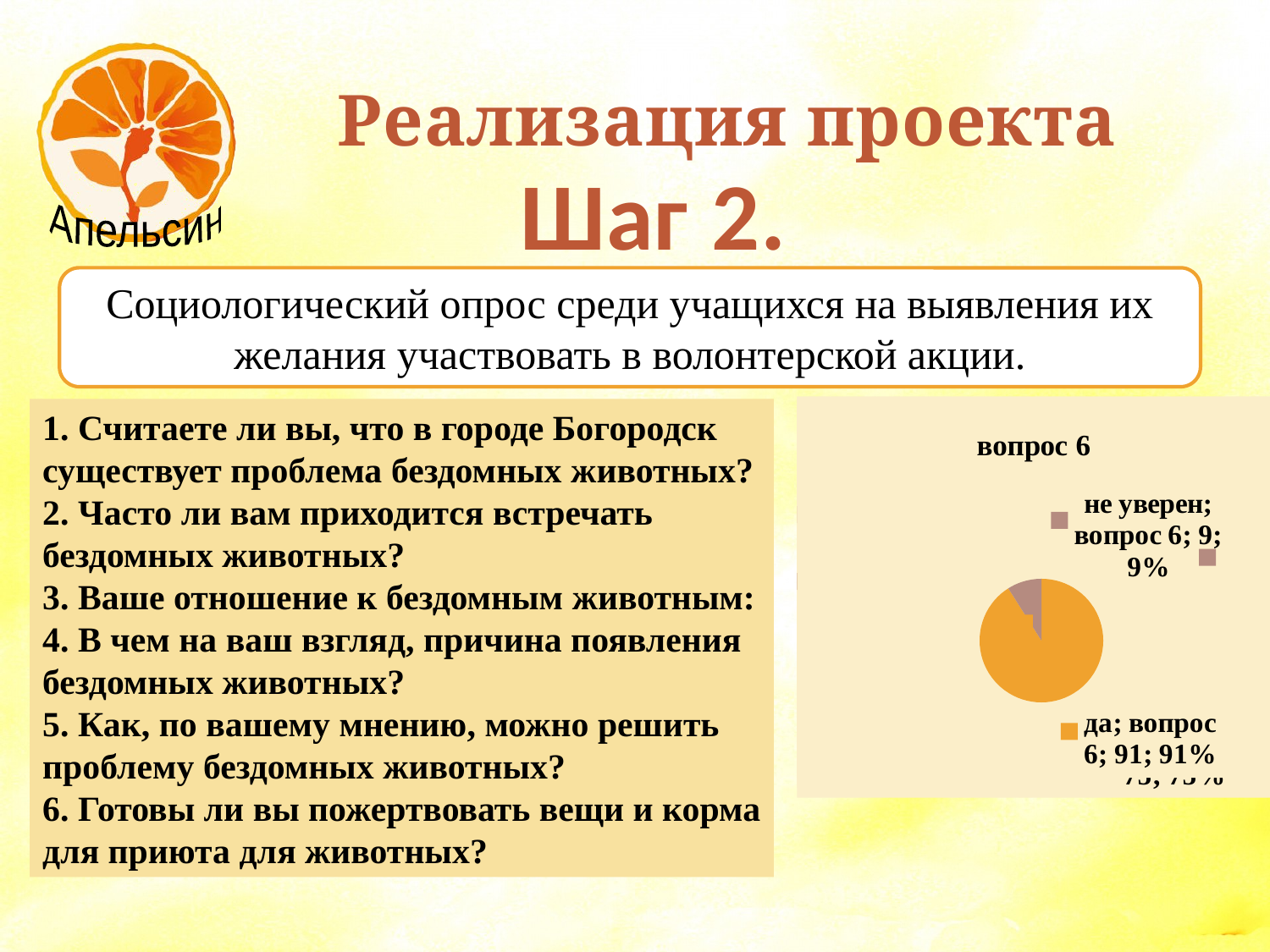
In the pie chart 'вопрос 6', which slice is the largest? да What kind of chart is shown on the slide? pie chart What is the title of the pie chart on the slide? вопрос 6 In the pie chart 'вопрос 6', what value is shown for the 'не уверен' slice? 9 In the pie chart 'вопрос 6', which is larger: the 'да' slice or the 'не уверен' slice? да In the pie chart 'вопрос 6', which slice is the smallest? не уверен In the pie chart 'вопрос 6', what share of the pie does the 'да' slice represent? 91% In the pie chart 'вопрос 6', what value is shown for the 'да' slice? 91 In the pie chart 'вопрос 6', what colour is the 'да' slice? orange In the pie chart 'вопрос 6', what share of the pie does the 'не уверен' slice represent? 9% In the pie chart 'вопрос 6', what is the difference between the 'да' value and the 'не уверен' value? 82 How many labelled slices does the pie chart 'вопрос 6' have? 2